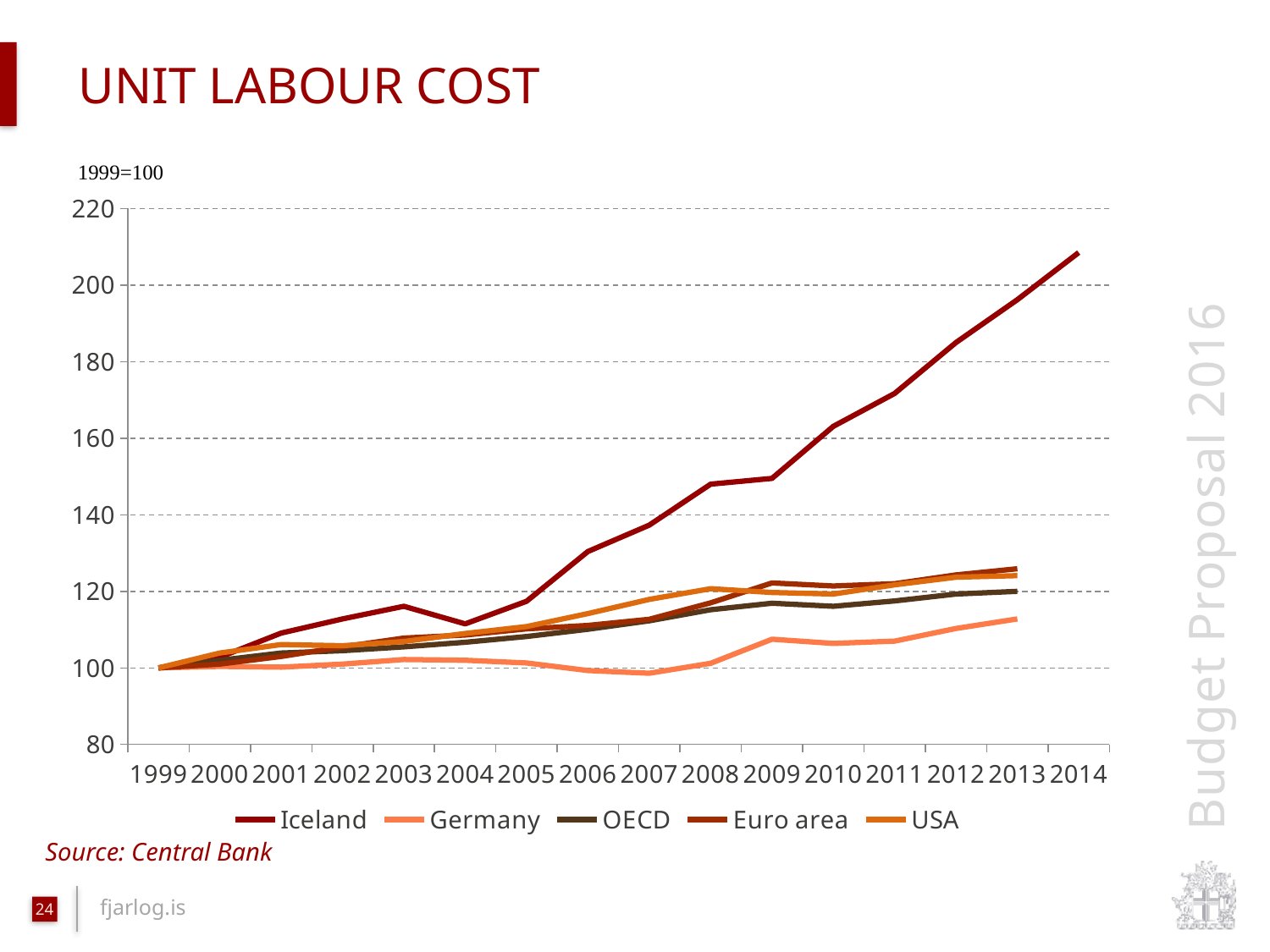
Is the value for Iceland in 2009 greater or less than 140? greater What kind of chart is shown on the slide? line chart Does the Iceland line rise or fall from 1999 to 2014? rises How many years are shown along the x axis? 16 Is the value for Iceland in 2014 greater or less than 200? greater What is the index value of all series in 1999? 100 In 2012, which is larger, the value for Iceland or the value for Germany? Iceland Which series reaches the highest value at the right end of the chart? Iceland Which series has the lowest value in 2013? Germany Is the value for Germany in 2013 greater or less than 120? less How many series does the legend list? 5 What source is cited for the chart? Central Bank